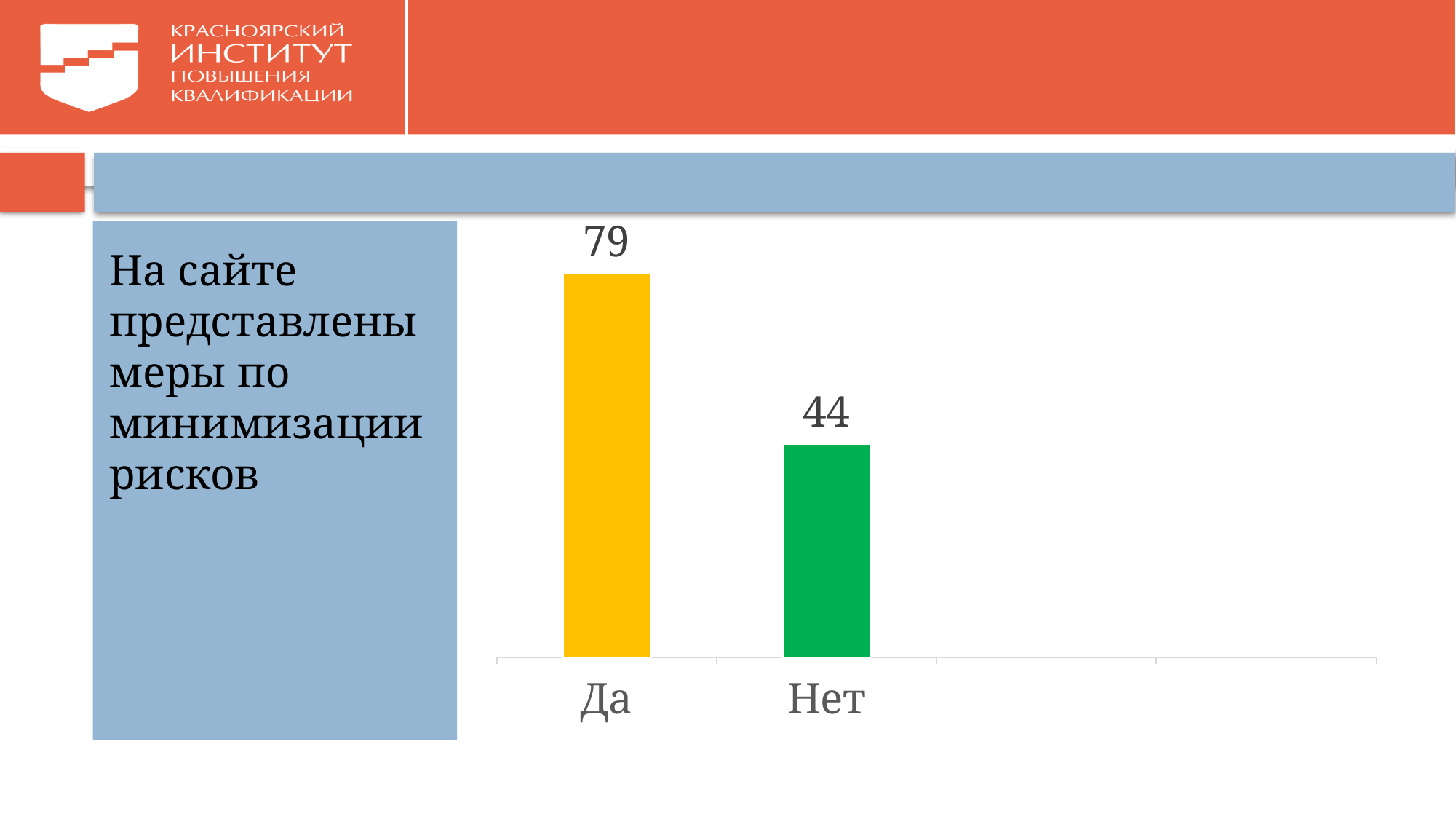
What is the total of the two values shown in the chart? 123 What kind of chart is shown on the slide? bar chart How many categories are shown in the chart? 2 Which category has the lowest value? Нет What is the value for Нет? 44 Do the values rise or fall from Да to Нет? fall What colour is the bar for Да? yellow Which category has the highest value? Да What is the difference between the values for Да and Нет? 35 What colour is the bar for Нет? green Which is larger, the value for Да or the value for Нет? Да What is the value for Да? 79